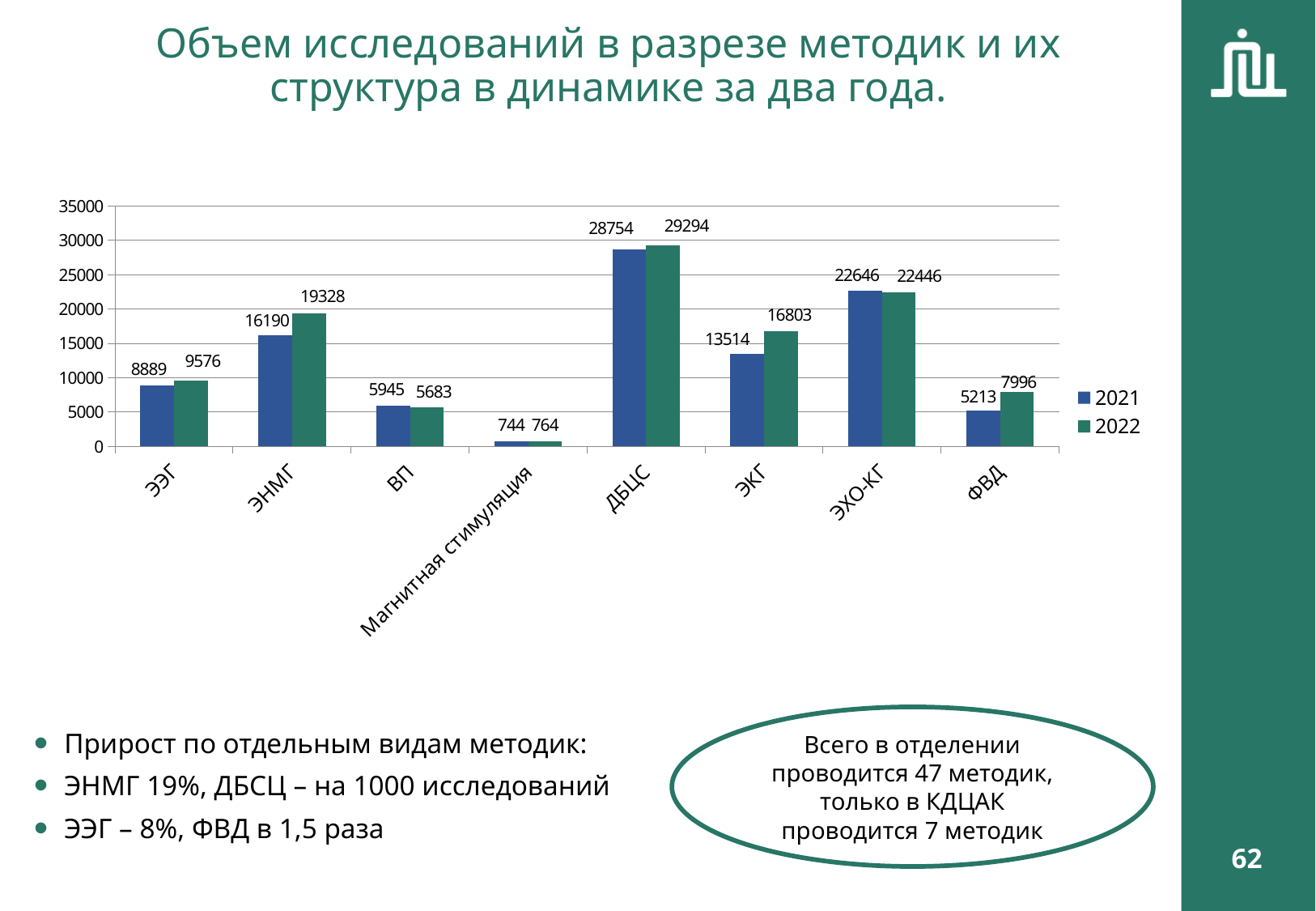
What is the value for ЭНМГ in 2021? 16190 How many categories are shown on the x axis? 8 What is the difference between the 2021 and 2022 values for ЭХО-КГ? 200 Which category has the highest value in 2021? ДБЦС Which is larger for ВП: the 2021 value or the 2022 value? 2021 Which category has the lowest value in 2022? Магнитная стимуляция What is the difference between the 2022 and 2021 values for ЭКГ? 3289 What kind of chart is shown on the slide? bar chart What is the value for ФВД in 2022? 7996 How many series does the legend list? 2 Is the 2022 value for ЭНМГ greater or less than 15000? greater What is the value for ДБЦС in 2022? 29294